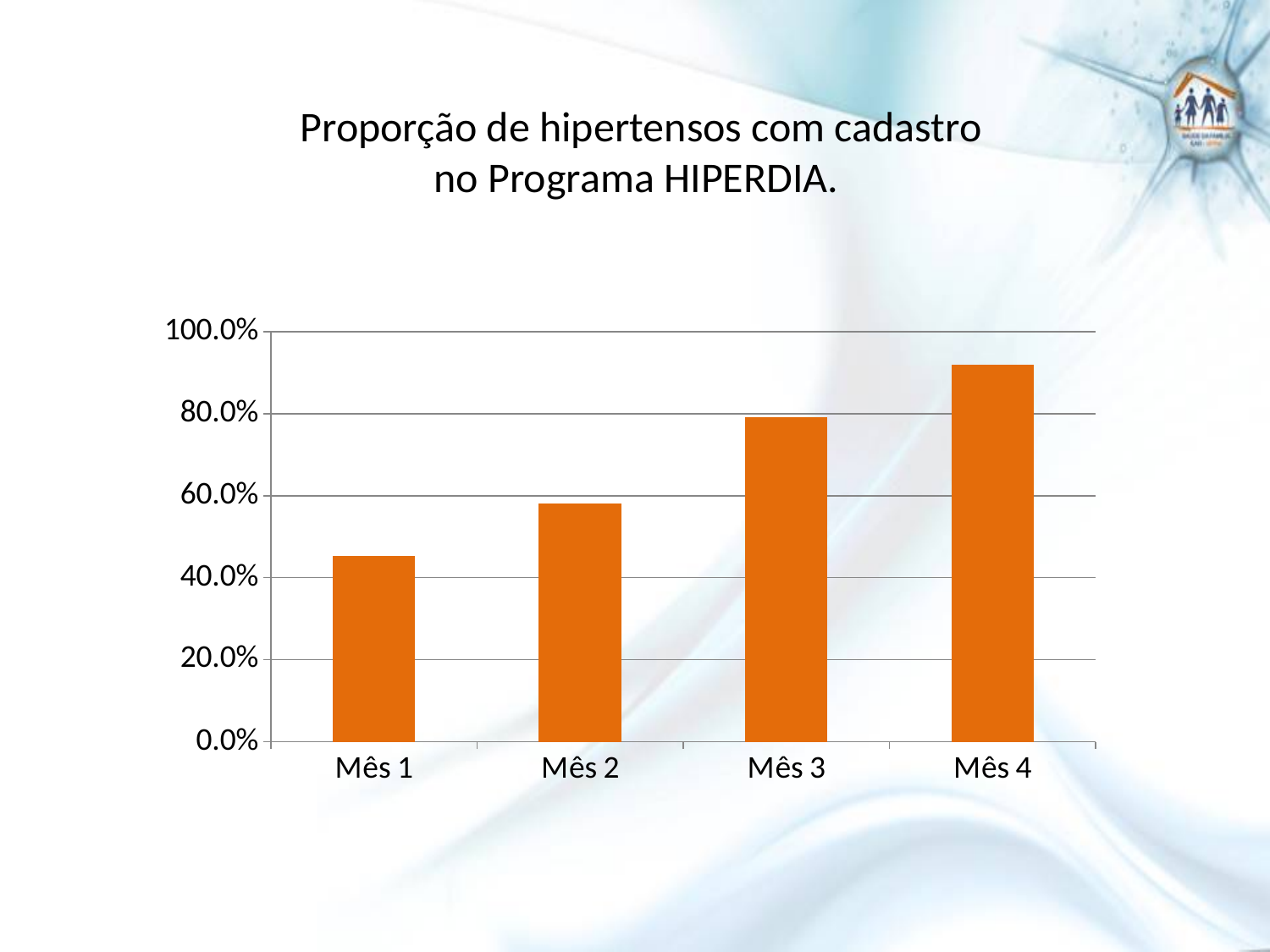
What kind of chart is shown on the slide? bar chart Which is larger, the value for Mês 2 or the value for Mês 3? Mês 3 Is the value for Mês 3 greater or less than 60.0%? greater Do the values rise or fall from Mês 1 to Mês 4? rise Which month has the highest proportion? Mês 4 How many categories (months) are shown on the x axis? 4 Is the value for Mês 1 greater or less than 60.0%? less Is the value for Mês 1 greater or less than 40.0%? greater What is the title of the chart? Proporção de hipertensos com cadastro no Programa HIPERDIA. Which month has the lowest proportion? Mês 1